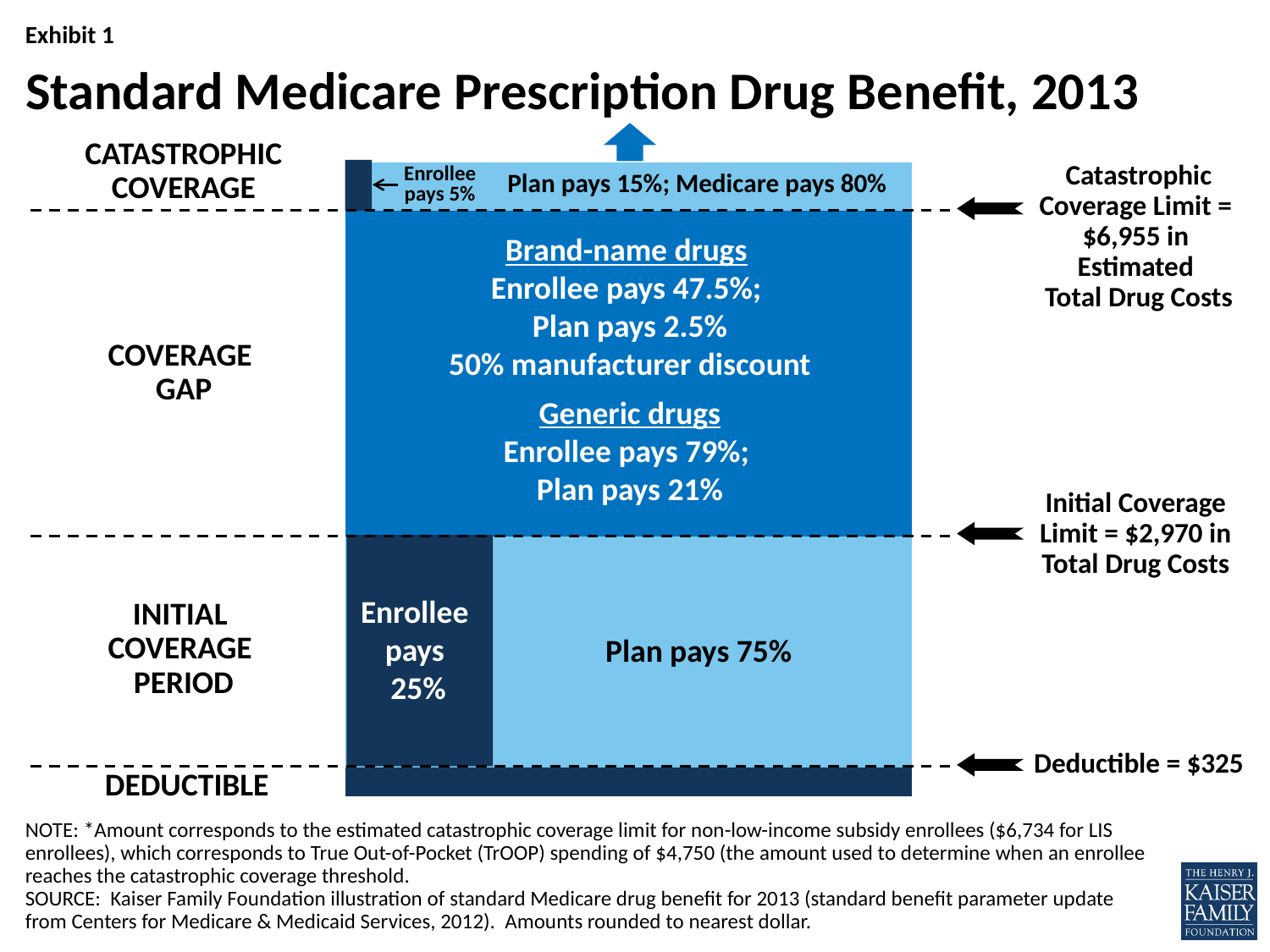
In Catastrophic Coverage, what percentage does the enrollee pay? 5% What is the title of the chart? Standard Medicare Prescription Drug Benefit, 2013 What is the Initial Coverage Limit in total drug costs? $2,970 What is the Catastrophic Coverage Limit in estimated total drug costs? $6,955 What is the difference between the Catastrophic Coverage Limit and the Initial Coverage Limit? $3,985 Which is larger: the enrollee's share for generic drugs in the Coverage Gap or the enrollee's share in the Initial Coverage Period? Generic drugs in the Coverage Gap In the Initial Coverage Period, what percentage does the enrollee pay? 25% In the Coverage Gap, what percentage does the enrollee pay for brand-name drugs? 47.5% In the Coverage Gap, what percentage does the enrollee pay for generic drugs? 79% In Catastrophic Coverage, what percentage does Medicare pay? 80% What is the deductible amount shown on the chart? $325 In the Initial Coverage Period, what percentage does the plan pay? 75%